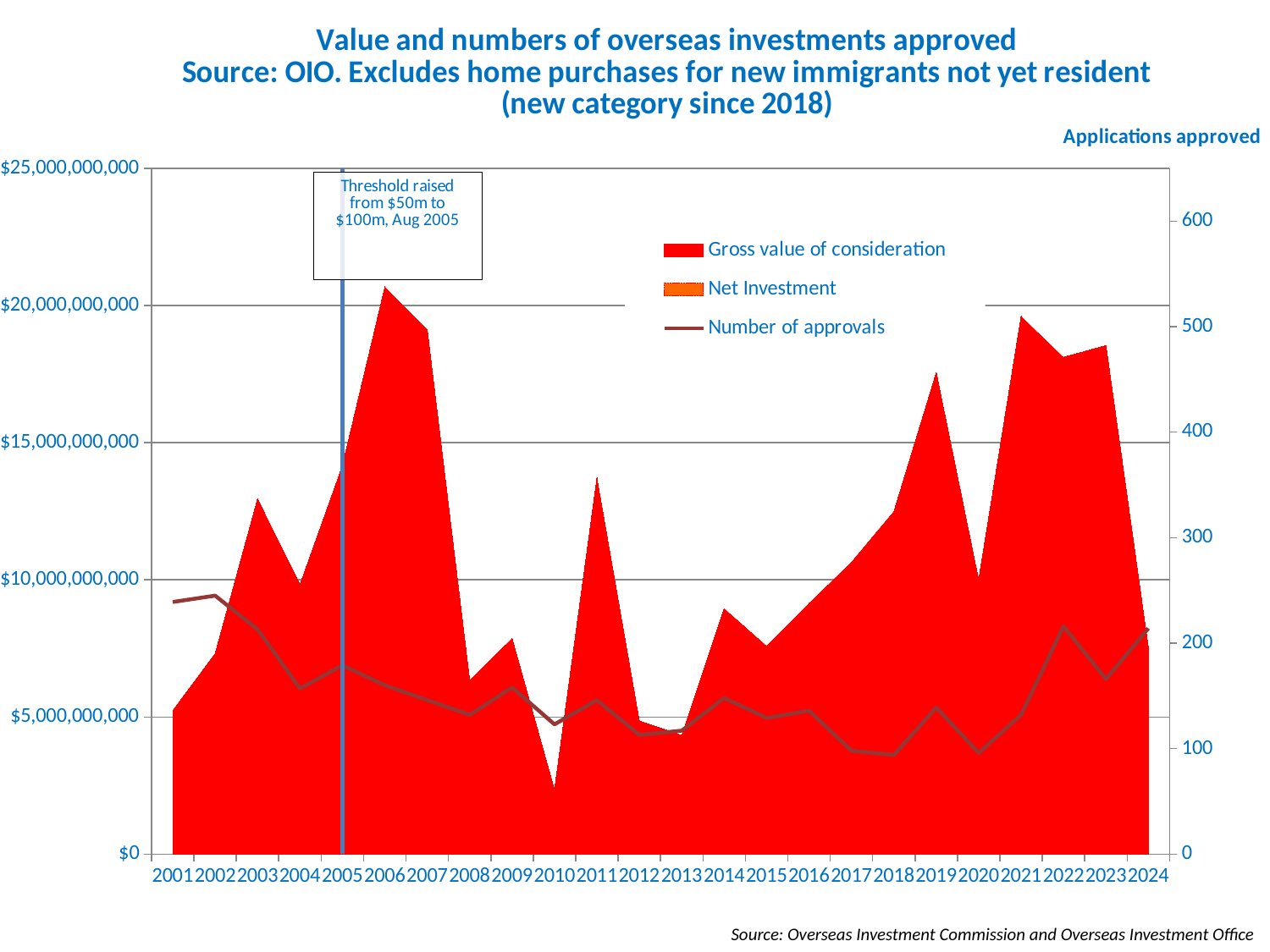
How many series does the legend list? 3 How many years are shown on the x axis? 24 What kind of chart is this? Area chart with a line Does the number of approvals rise or fall from 2001 to 2004? fall Is the number of approvals in 2001 greater or less than 200? greater Is the number of approvals in 2010 greater or less than 200? less In which year is the gross value of consideration lowest? 2010 Is the gross value of consideration in 2010 greater or less than $5,000,000,000? less In which year is the gross value of consideration highest? 2006 Which year has the larger gross value of consideration, 2006 or 2011? 2006 What is the title of the right-hand axis? Applications approved